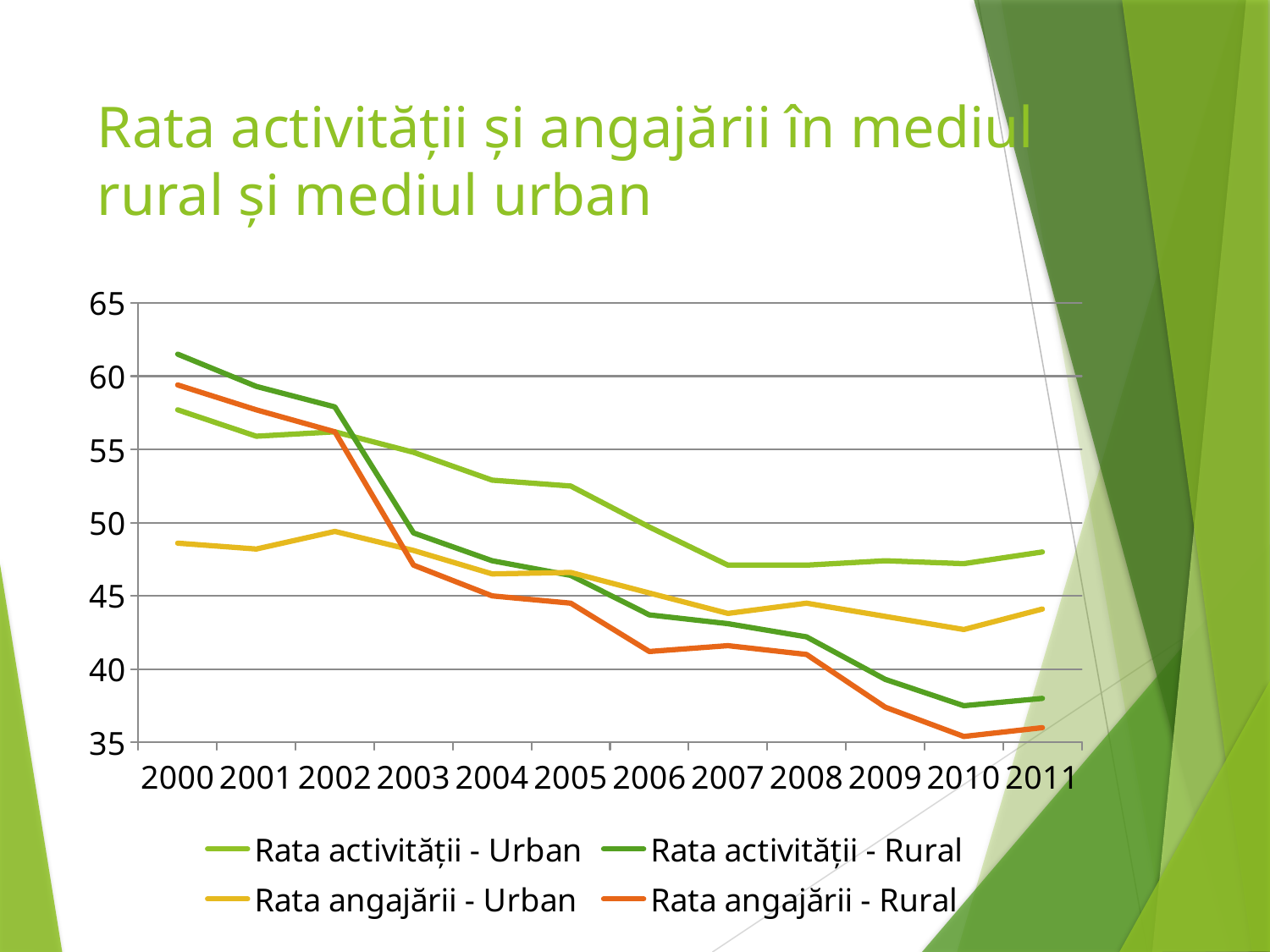
In which year is Rata angajării - Rural at its lowest? 2010 Is the value for Rata activității - Rural in 2000 greater or less than 60? greater Is the value for Rata angajării - Rural in 2010 greater or less than 40? less What type of chart is shown on the slide? line chart In which year is Rata activității - Rural at its highest? 2000 How many years are shown on the x axis? 12 Does the Rata activității - Rural series rise or fall from 2000 to 2011? fall Is the value for Rata angajării - Urban in 2000 greater or less than 50? less How many series does the legend list? 4 In 2000, which is larger: Rata activității - Rural or Rata activității - Urban? Rata activității - Rural In 2011, which is larger: Rata activității - Urban or Rata angajării - Rural? Rata activității - Urban Which series is drawn in orange? Rata angajării - Rural